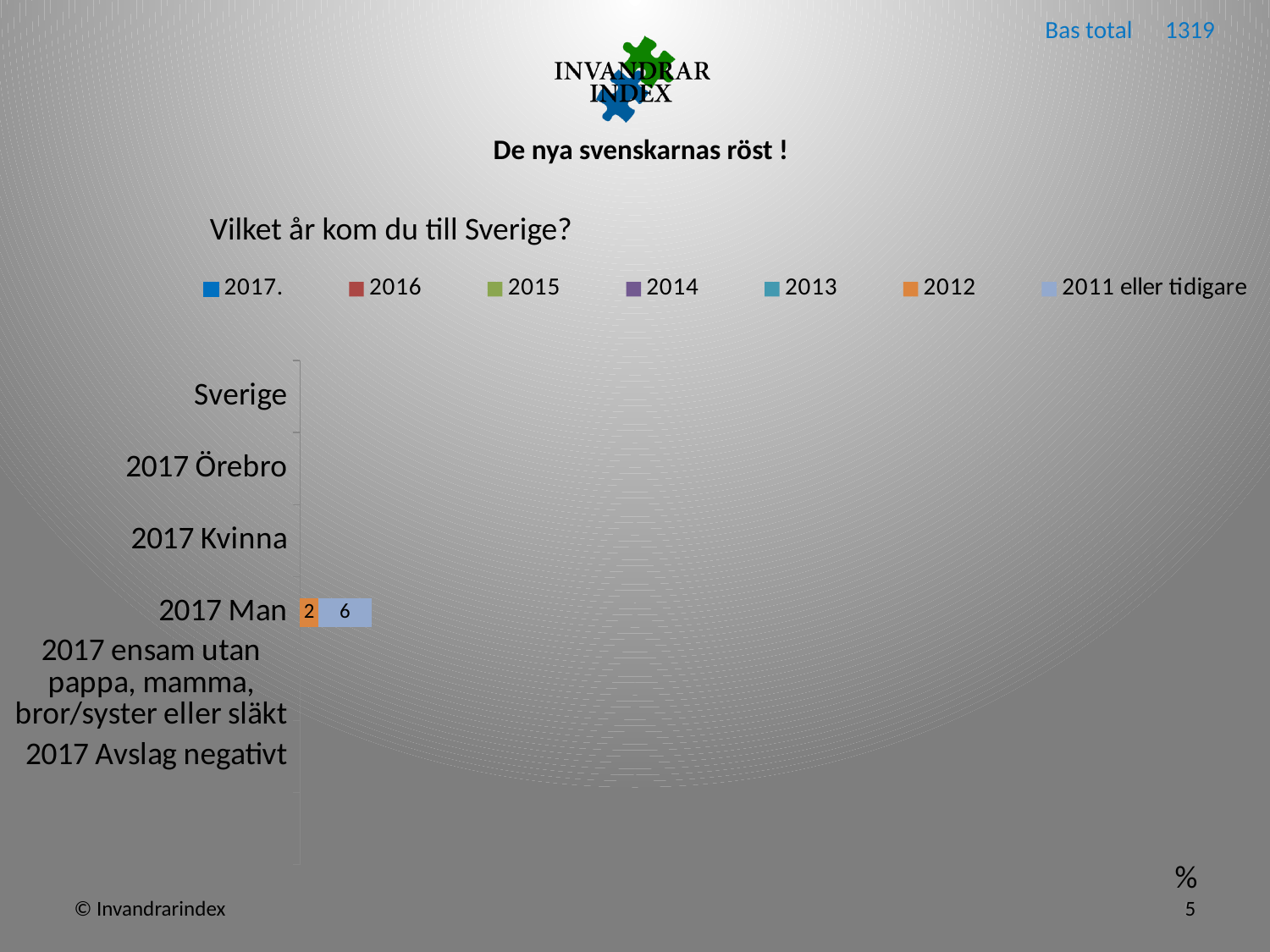
For the category 2017 Man, which is larger: the 2012 segment or the '2011 eller tidigare' segment? 2011 eller tidigare What kind of chart is shown on the slide? bar chart What is the value of the '2011 eller tidigare' segment for the category 2017 Man? 6 What is the title of the chart? Vilket år kom du till Sverige? For the category 2017 Man, what is the difference between the '2011 eller tidigare' segment and the 2012 segment? 4 How many categories are shown on the vertical axis of the chart? 6 What is the last entry listed in the chart legend? 2011 eller tidigare Which category is the only one with visible data labels in the chart? 2017 Man How many series does the chart legend list? 7 What is the value of the 2012 segment for the category 2017 Man? 2